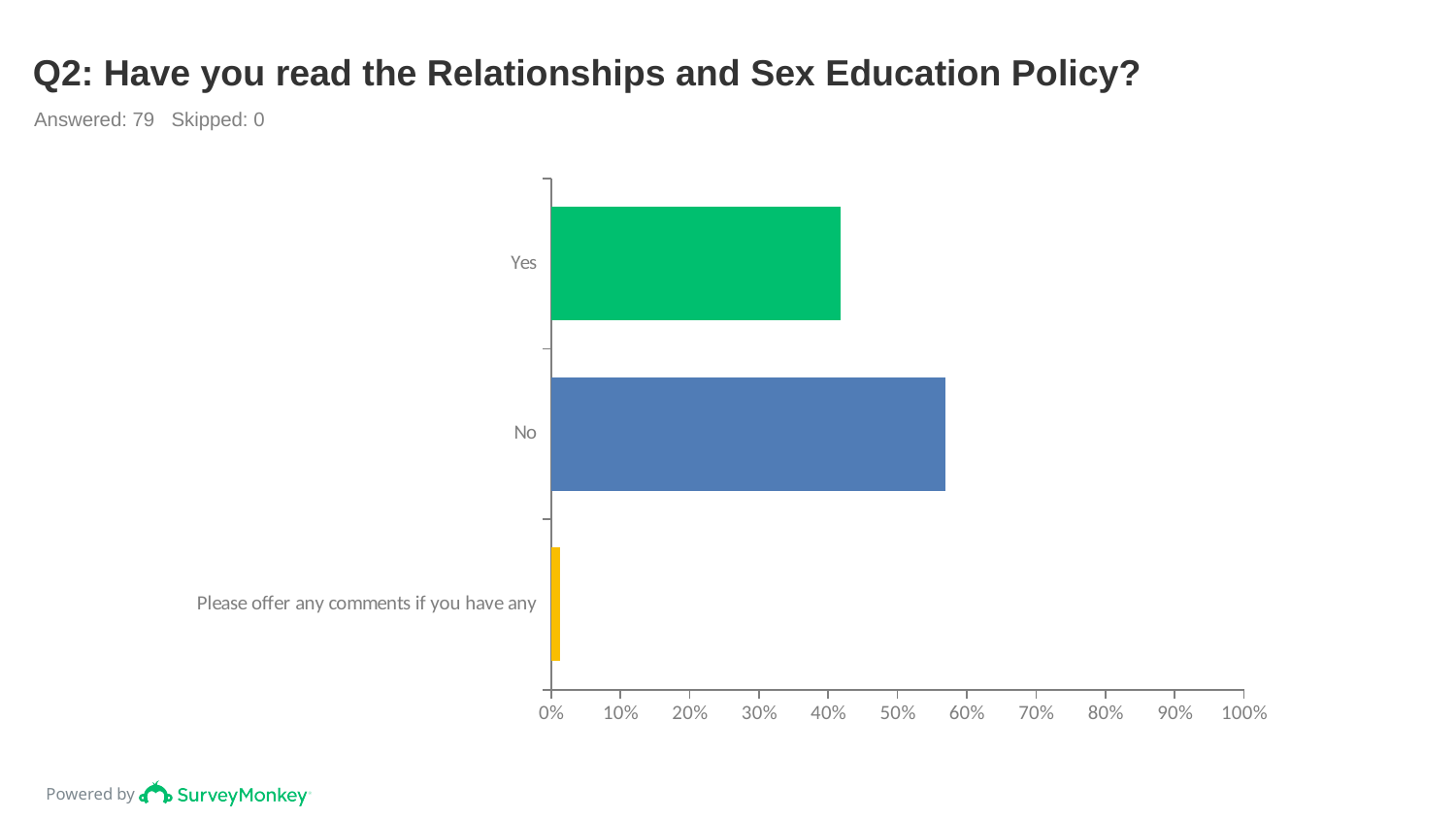
What is the highest value shown on the x axis? 100% Which is larger, the value for Yes or the value for No? No What is the title of the chart? Q2: Have you read the Relationships and Sex Education Policy? Is the value for Yes greater or less than 30%? greater Is the value for Yes greater or less than 50%? less Which category has the lowest value? Please offer any comments if you have any Is the value for No greater or less than 50%? greater Which category has the highest value? No What kind of chart is shown on the slide? bar chart How many categories are plotted in the chart? 3